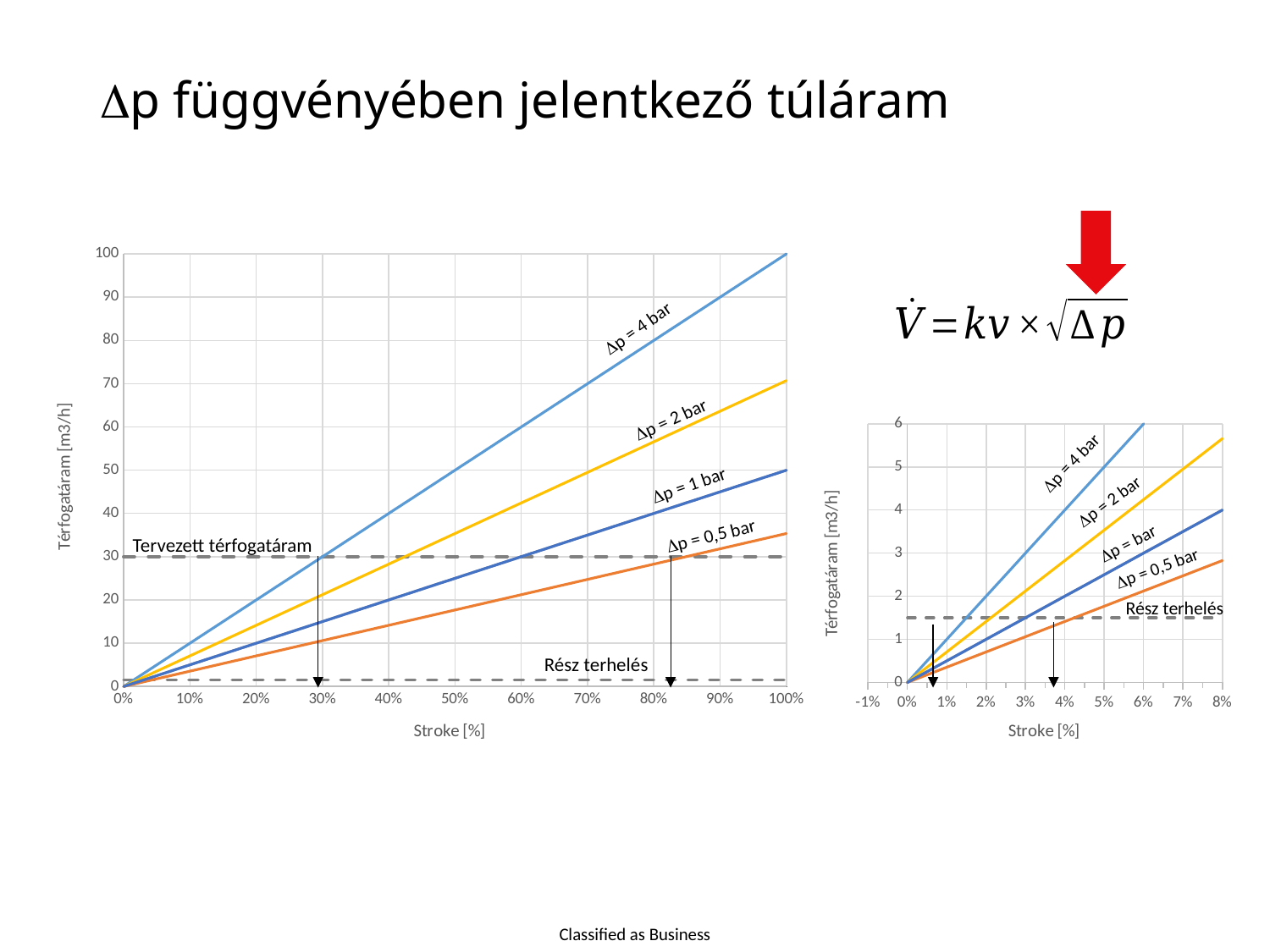
On the left chart, at 50% stroke, which line is higher: Δp = 2 bar or Δp = 1 bar? Δp = 2 bar What is the x-axis title of the right chart? Stroke [%] On the left chart, is the value of the Δp = 0,5 bar line at 100% stroke greater or less than 40? less On the left chart, how many Δp lines are plotted? 4 On the left chart, what flow (m3/h) does the Δp = 1 bar line reach at 100% stroke? 50 On the left chart, which Δp line has the lowest flow at 100% stroke? Δp = 0,5 bar On the left chart, at what flow value (m3/h) is the dashed 'Tervezett térfogatáram' line drawn? 30 On the left chart, is the value of the Δp = 2 bar line at 100% stroke greater or less than 60? greater What kind of chart is the left chart on the slide? line chart On the left chart, which Δp line reaches the highest flow at 100% stroke? Δp = 4 bar On the left chart, what flow (m3/h) does the Δp = 4 bar line reach at 100% stroke? 100 On the left chart, do the Δp lines rise or fall as stroke increases? rise